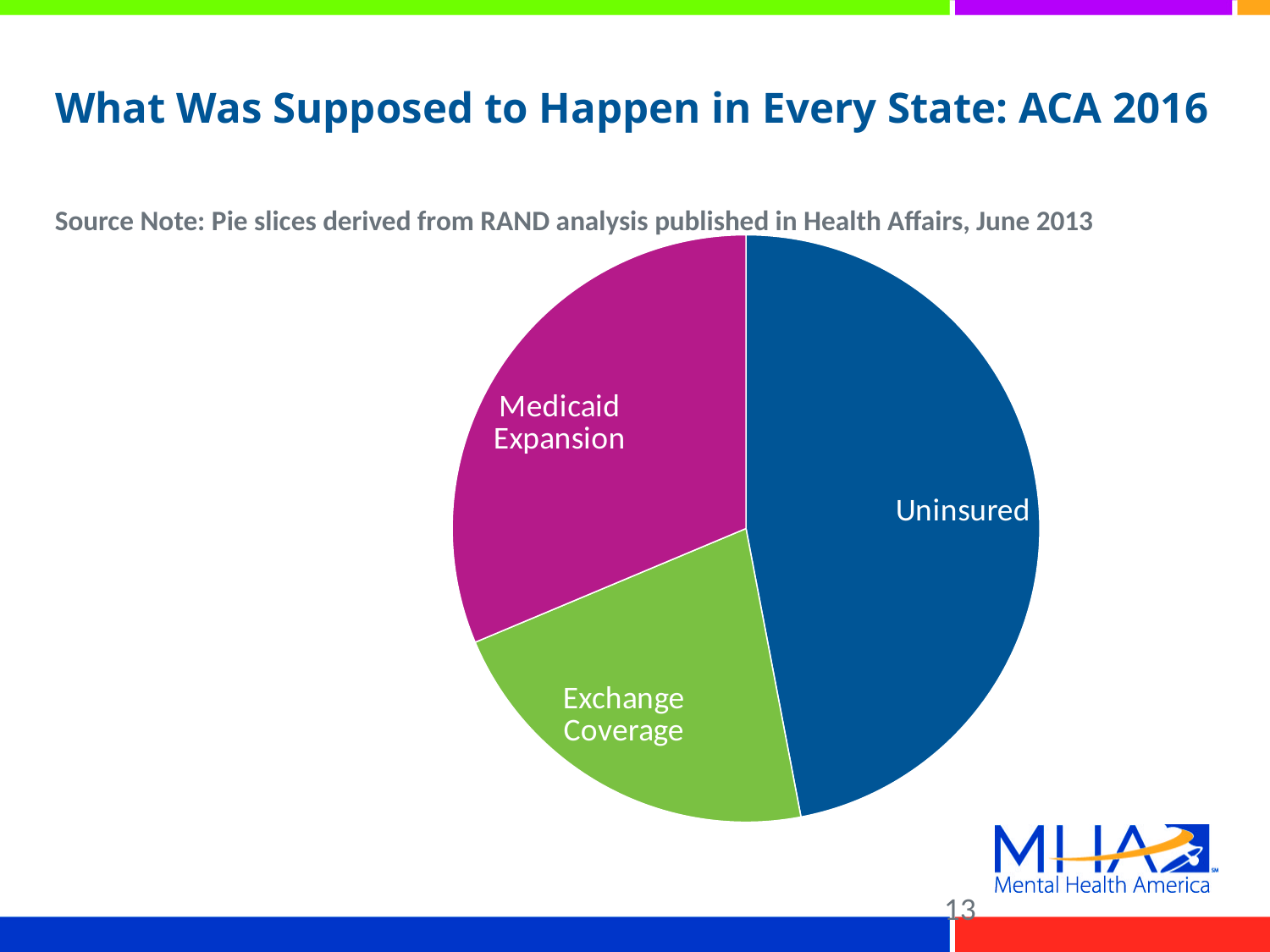
What kind of chart is shown on the slide? Pie chart What colour is the Uninsured slice of the pie chart? Blue Which slice of the pie chart is the largest? Uninsured How many slices does the pie chart have? 3 What is the title of the slide containing the pie chart? What Was Supposed to Happen in Every State: ACA 2016 Which slice is larger, Medicaid Expansion or Exchange Coverage? Medicaid Expansion Which slice is larger, Uninsured or Exchange Coverage? Uninsured Which slice of the pie chart is the smallest? Exchange Coverage Which slice is larger, Uninsured or Medicaid Expansion? Uninsured